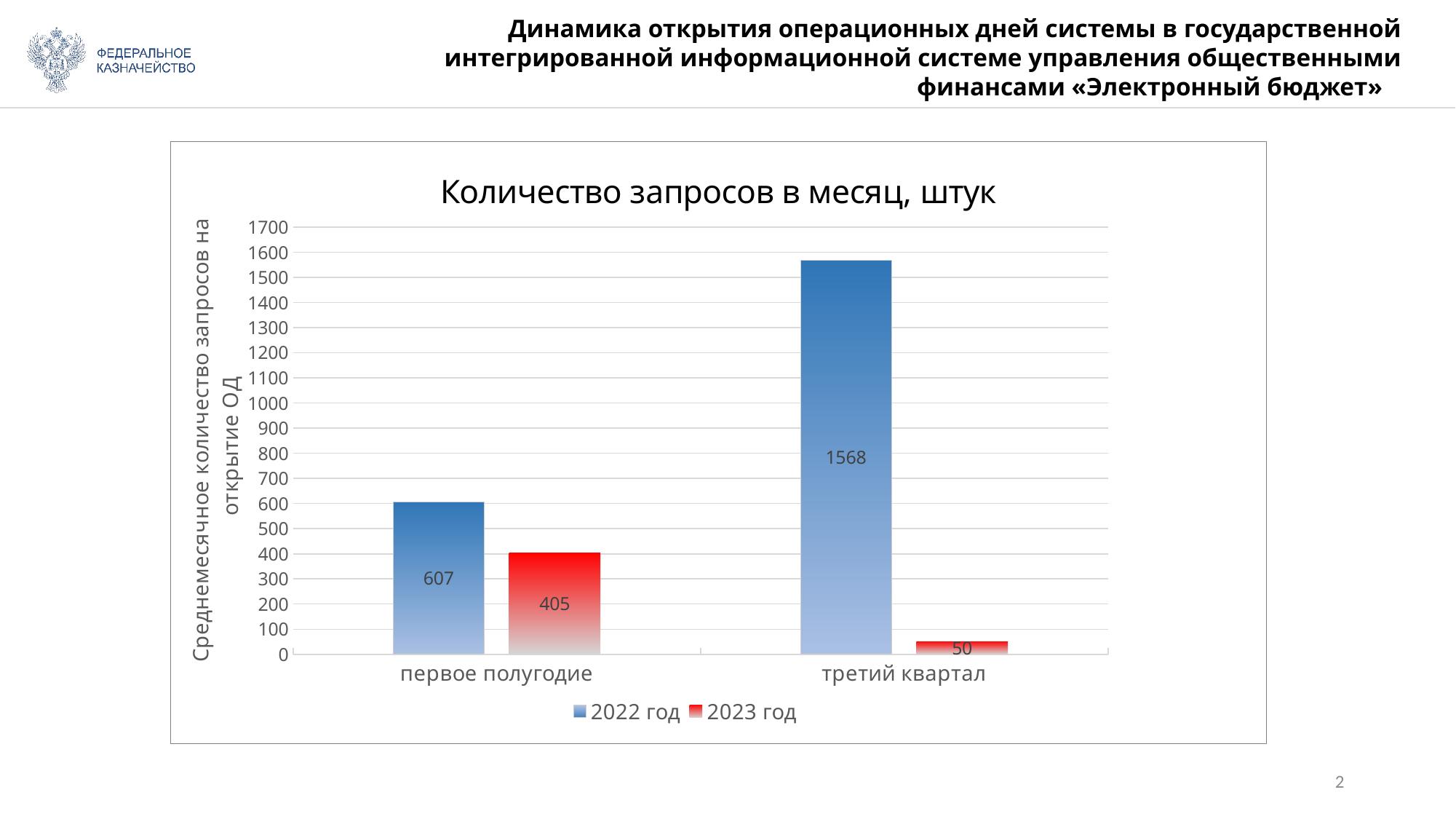
How many series does the legend list? 2 What is the difference between the 2022 год and 2023 год values for третий квартал? 1518 What is the difference between the 2022 год and 2023 год values for первое полугодие? 202 Which bar has the lowest value on the chart? 2023 год, третий квартал Which is larger: the 2022 год value for первое полугодие or the 2023 год value for первое полугодие? 2022 год Which bar has the highest value on the chart? 2022 год, третий квартал What is the value for 2022 год in the третий квартал category? 1568 What type of chart is shown on the slide? bar chart What is the value for 2022 год in the первое полугодие category? 607 What is the value for 2023 год in the третий квартал category? 50 What is the value for 2023 год in the первое полугодие category? 405 How many categories are shown on the x axis? 2